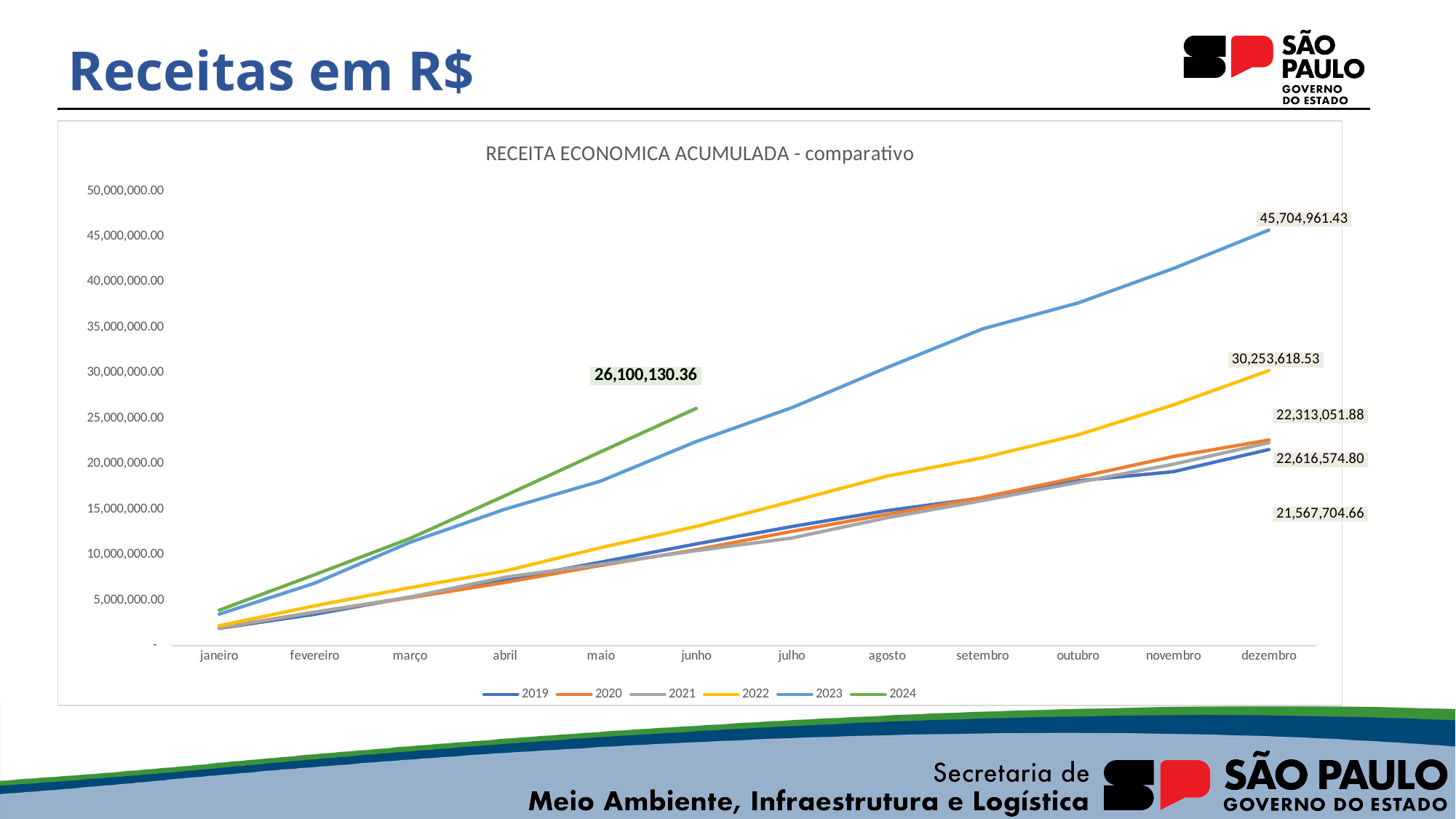
How many months are shown along the x axis? 12 How many series does the legend list? 6 What is the value for 2024 in junho? 26,100,130.36 Is the value for 2023 in setembro greater or less than 30,000,000.00? greater Which is larger in dezembro, the value for 2023 or the value for 2022? 2023 What is the difference between the 2023 and 2022 values in dezembro? 15,451,342.90 Do the values for 2023 rise or fall from janeiro to dezembro? rise What is the value for 2023 in dezembro? 45,704,961.43 What type of chart is shown on the slide? line chart Is the value for 2022 in agosto greater or less than 20,000,000.00? less Which series has the highest value in dezembro? 2023 What is the value for 2022 in dezembro? 30,253,618.53